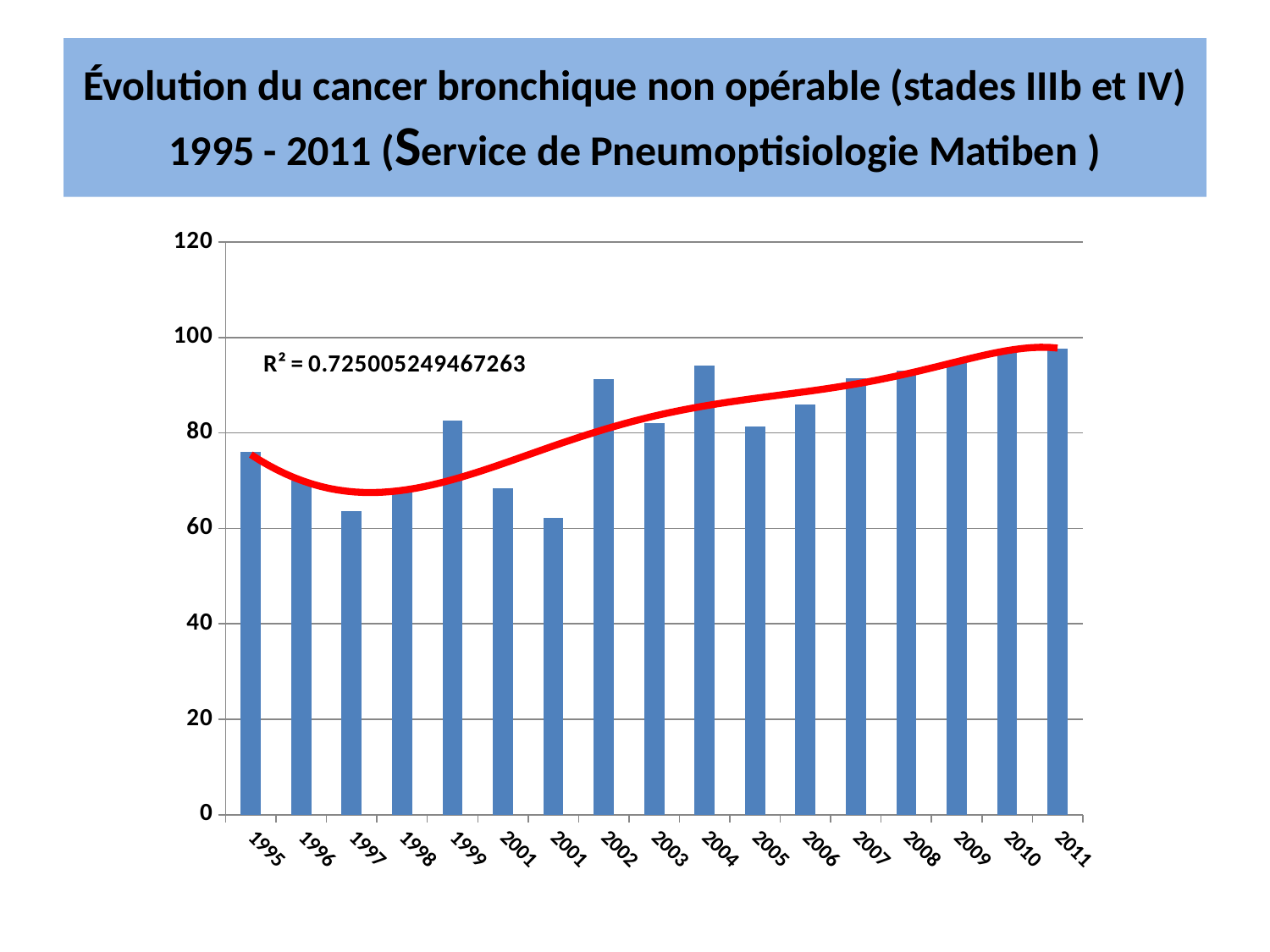
Is the value for 2004 greater or less than 100? less How many bars are plotted in the chart? 17 Which is larger, the value for 2004 or the value for 2005? 2004 What R² value is printed on the chart? R² = 0.725005249467263 What kind of chart is shown on the slide? bar chart Do the values generally rise or fall from 1995 to 2011? rise Is the value for 2002 greater or less than 80? greater What colour is the trend line drawn over the bars? red Is the value for 1997 greater or less than 60? greater Which is larger, the value for 1999 or the value for 1998? 1999